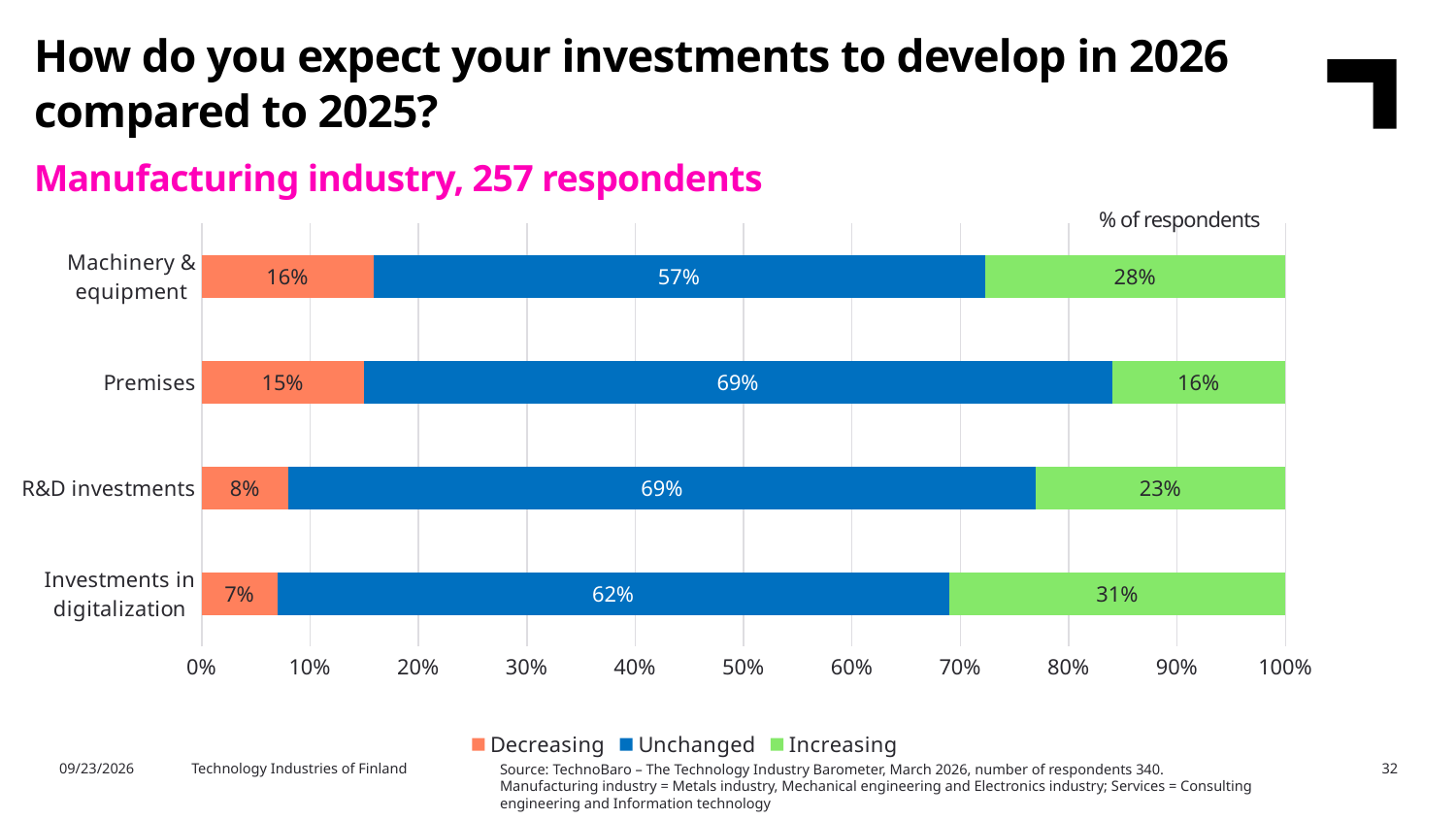
What percentage of respondents expect Investments in digitalization to be Increasing? 31% Which category has the highest share of respondents expecting Increasing investments? Investments in digitalization What is the difference between the Increasing share for Machinery & equipment and the Increasing share for Premises? 12 percentage points What percentage of respondents expect Premises investments to be Unchanged? 69% What kind of chart is shown on the slide? Stacked bar chart Which category has the lowest share of respondents expecting Decreasing investments? Investments in digitalization What percentage of respondents expect R&D investments to be Decreasing? 8% How many investment categories are shown in the chart? 4 Which series is shown in blue in the legend? Unchanged How many series does the legend list? 3 What percentage of respondents expect Machinery & equipment investments to be Increasing? 28% Which is larger: the Decreasing share for Machinery & equipment or the Decreasing share for R&D investments? Machinery & equipment